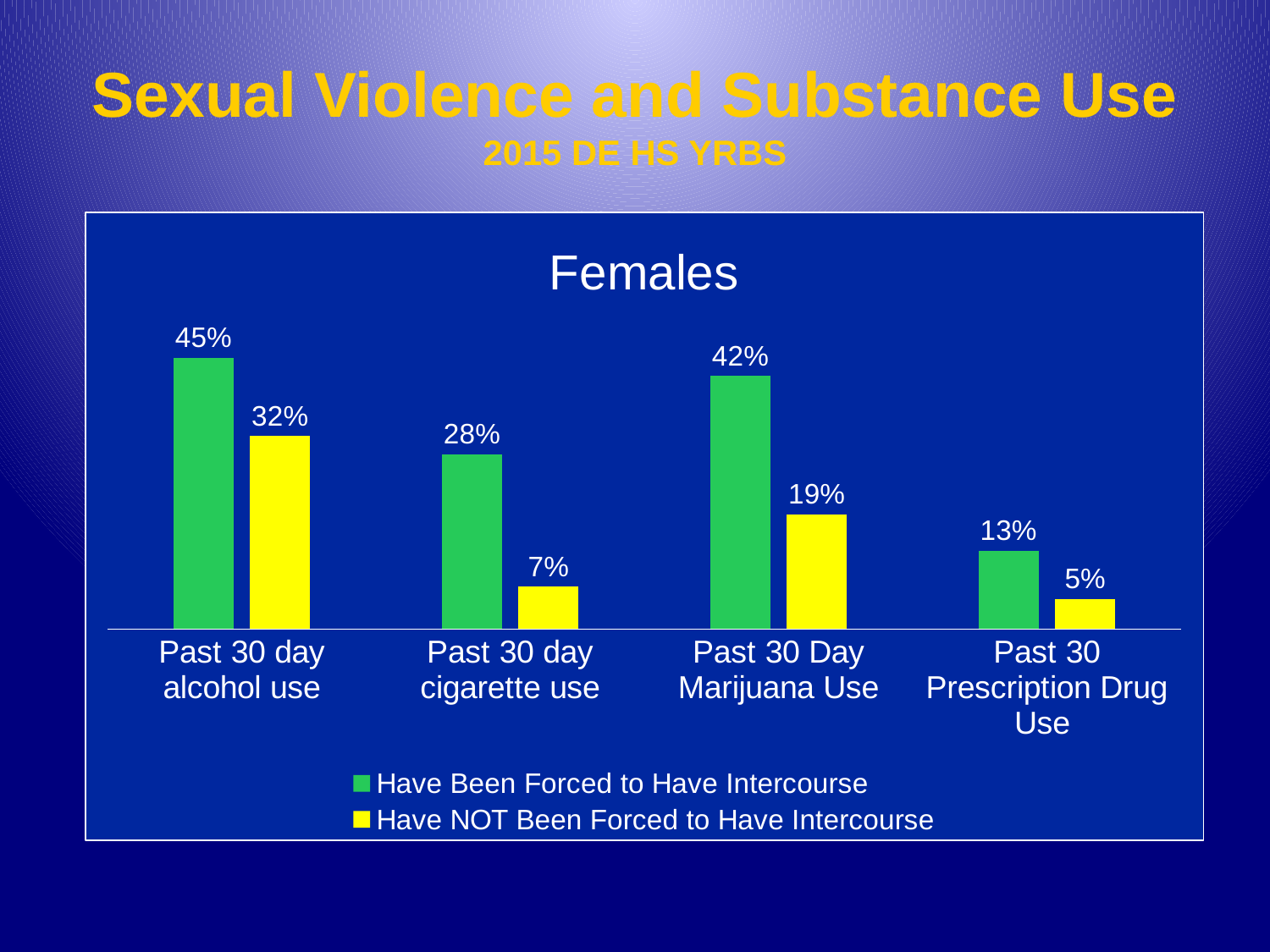
Which category has the highest value for females who have been forced to have intercourse? Past 30 day alcohol use Which category has the lowest value for females who have NOT been forced to have intercourse? Past 30 Prescription Drug Use How many categories are shown on the x axis of the chart? 4 What is the value for Past 30 Prescription Drug Use among females who have been forced to have intercourse? 13% What is the value for Past 30 day cigarette use among females who have NOT been forced to have intercourse? 7% How many series does the legend list? 2 What kind of chart is shown on the slide? Bar chart What is the difference between the two series for Past 30 Day Marijuana Use? 23% What is the value for Past 30 Day Marijuana Use among females who have NOT been forced to have intercourse? 19% What is the difference between the two series for Past 30 day cigarette use? 21% For Past 30 day alcohol use, which series has the larger value? Have Been Forced to Have Intercourse What is the value for Past 30 day alcohol use among females who have been forced to have intercourse? 45%